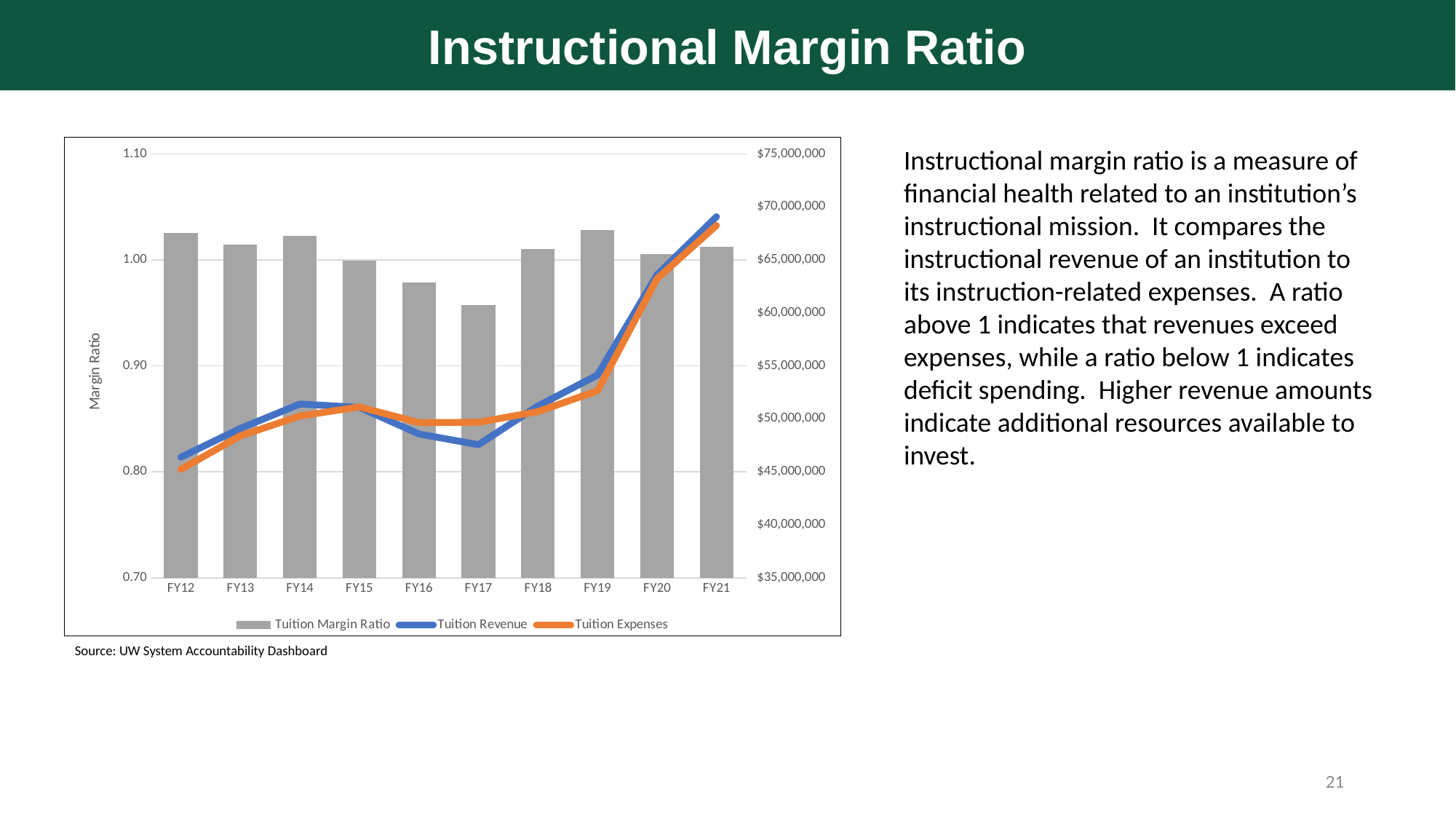
How many series does the chart's legend list? 3 Does Tuition Revenue rise or fall from FY17 to FY21? rise Is the Tuition Margin Ratio for FY19 greater or less than 1.00? greater Is the Tuition Revenue for FY21 greater or less than $65,000,000? greater Which fiscal year has the highest Tuition Revenue? FY21 Which is larger, the Tuition Margin Ratio for FY17 or for FY19? FY19 Is the Tuition Margin Ratio for FY17 greater or less than 1.00? less What kind of chart is shown on the slide? Combined bar and line chart How many fiscal years are shown on the x axis of the chart? 10 Which fiscal year has the lowest Tuition Margin Ratio bar? FY17 Which fiscal year has the lowest Tuition Expenses? FY12